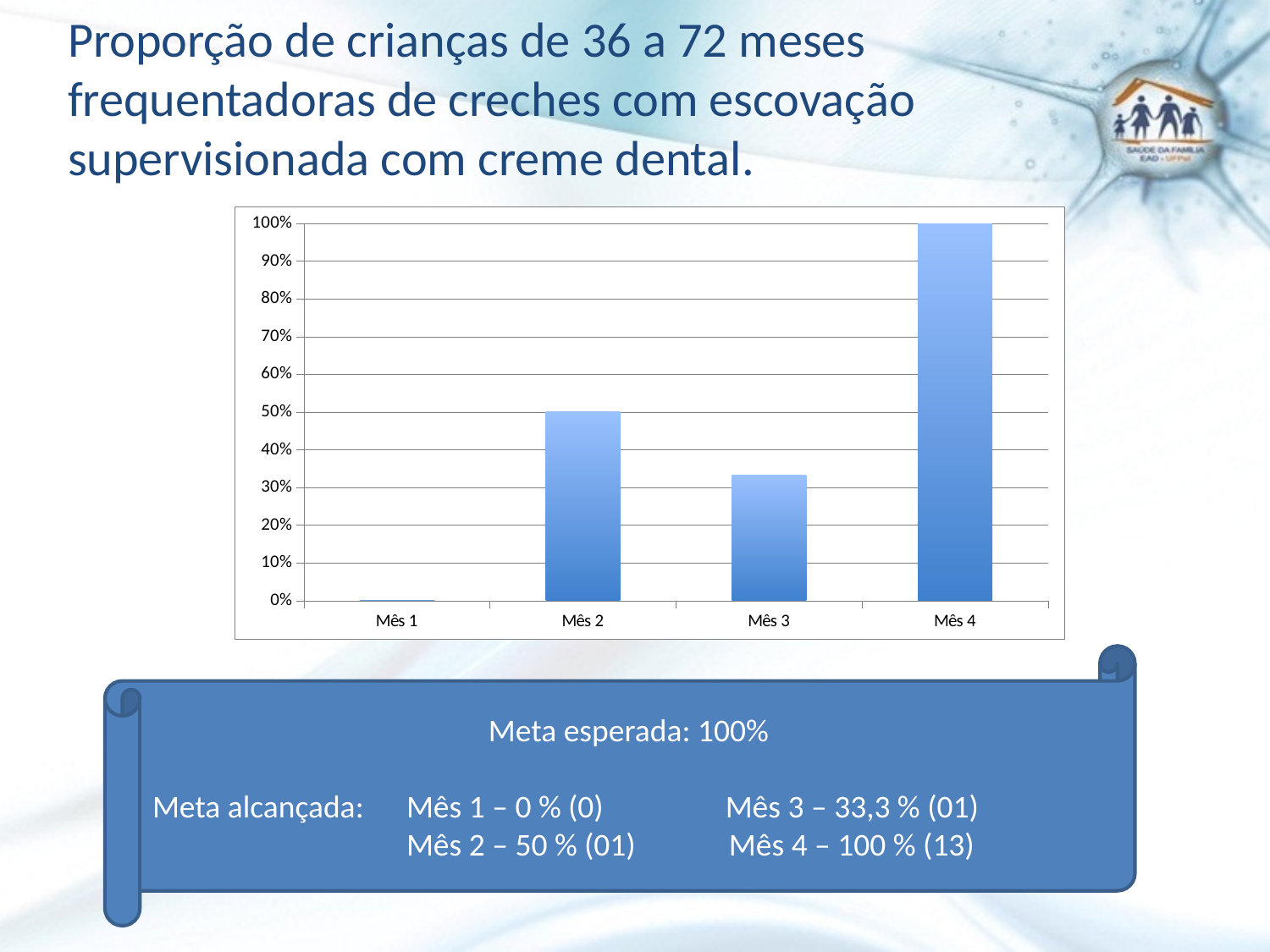
What kind of chart is shown on the slide? bar chart What is the difference between the values for Mês 4 and Mês 2? 50% Is the value for Mês 3 greater or less than 40%? less Which is larger, the value for Mês 2 or the value for Mês 3? Mês 2 What is the value for Mês 1 in the chart? 0% What is the highest tick value shown on the y axis of the chart? 100% Is the value for Mês 3 greater or less than 30%? greater What is the value for Mês 2 in the chart? 50% Which month has the highest value in the chart? Mês 4 Which month has the lowest value in the chart? Mês 1 How many categories (months) are plotted on the x axis of the chart? 4 What is the value for Mês 4 in the chart? 100%